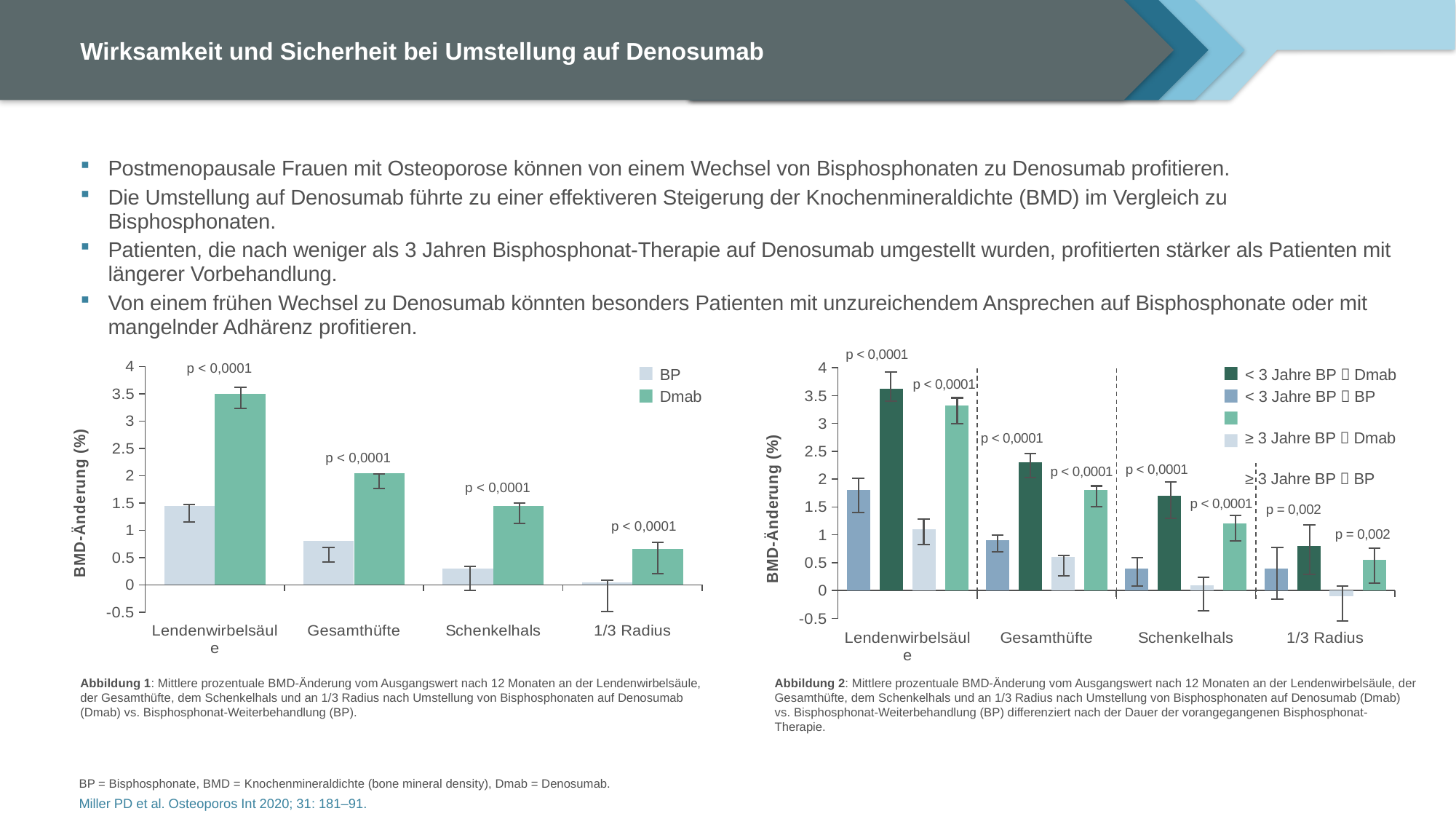
In Abbildung 2 (the right chart), what p-value is printed above the 1/3 Radius bars? p = 0,002 In Abbildung 1 (the left chart), which series has the larger value at Schenkelhals, BP or Dmab? Dmab In Abbildung 1 (the left chart), do the Dmab values rise or fall from Lendenwirbelsäule to 1/3 Radius? fall In Abbildung 1 (the left chart), is the BP value for Gesamthüfte greater or less than 1? less In Abbildung 2 (the right chart), is the value of the tallest bar at Lendenwirbelsäule greater or less than 3? greater What kind of chart is Abbildung 1 (the left chart)? bar chart In Abbildung 1 (the left chart), which category has the highest Dmab value? Lendenwirbelsäule In Abbildung 1 (the left chart), is the Dmab value for Lendenwirbelsäule greater or less than 3? greater In Abbildung 1 (the left chart), how many series does the legend list? 2 In Abbildung 1 (the left chart), what p-value is printed above the Lendenwirbelsäule bars? p < 0,0001 In Abbildung 1 (the left chart), how many categories are shown on the x axis? 4 In Abbildung 2 (the right chart), how many categories are shown on the x axis? 4